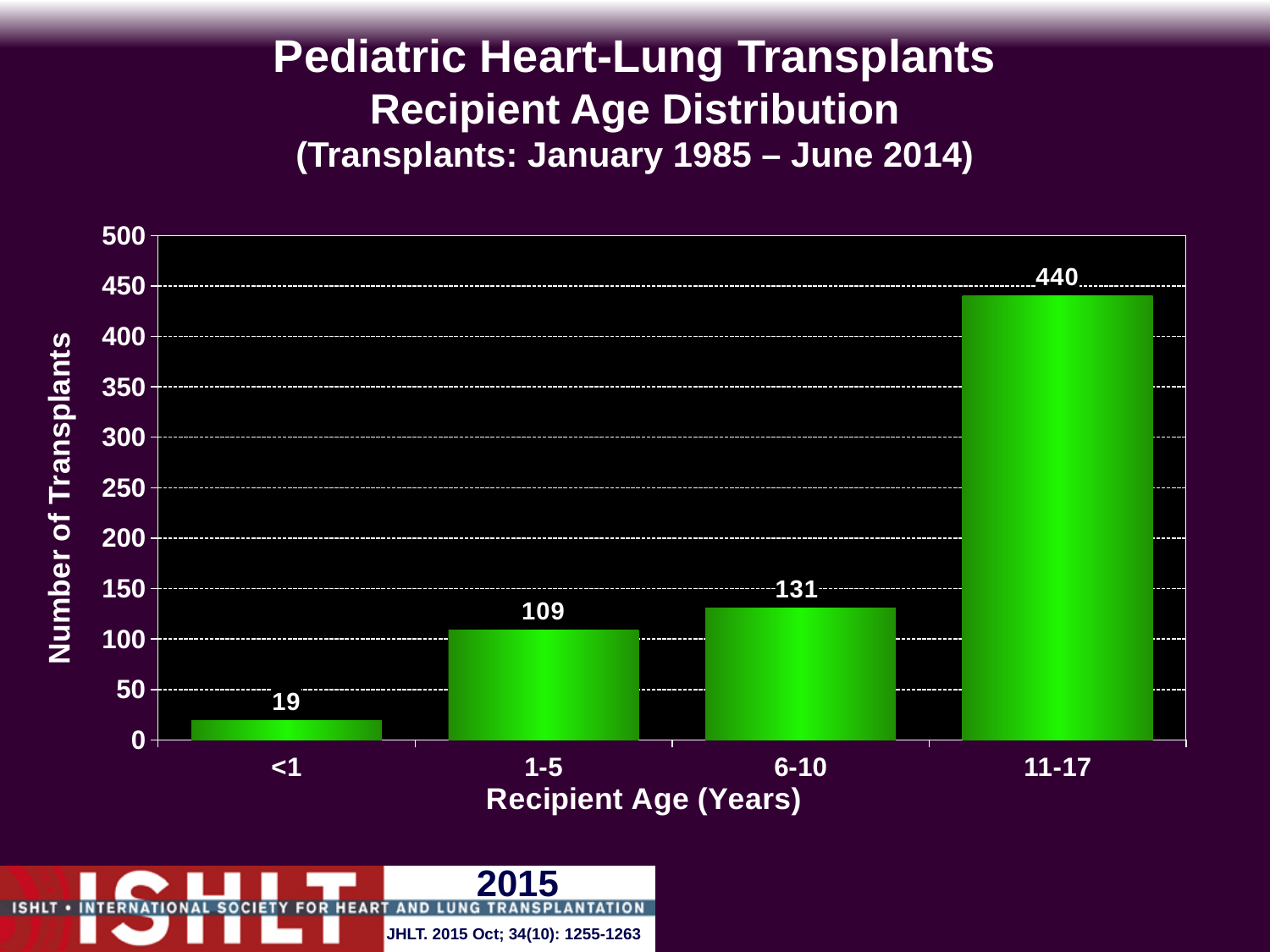
Which recipient age group has the highest number of transplants? 11-17 Which age group has more transplants, 1-5 or 6-10? 6-10 How many recipient age groups are shown on the chart? 4 What is the difference in number of transplants between the 11-17 and 6-10 age groups? 309 What is the number of transplants for recipients aged 1-5? 109 Is the number of transplants for the 11-17 age group greater or less than 400? greater What is the label of the y axis? Number of Transplants What type of chart is shown on the slide? bar chart What is the number of transplants for the <1 age group? 19 Which recipient age group has the lowest number of transplants? <1 What is the difference in number of transplants between the 6-10 and 1-5 age groups? 22 How many transplants are shown for recipients aged 11-17? 440